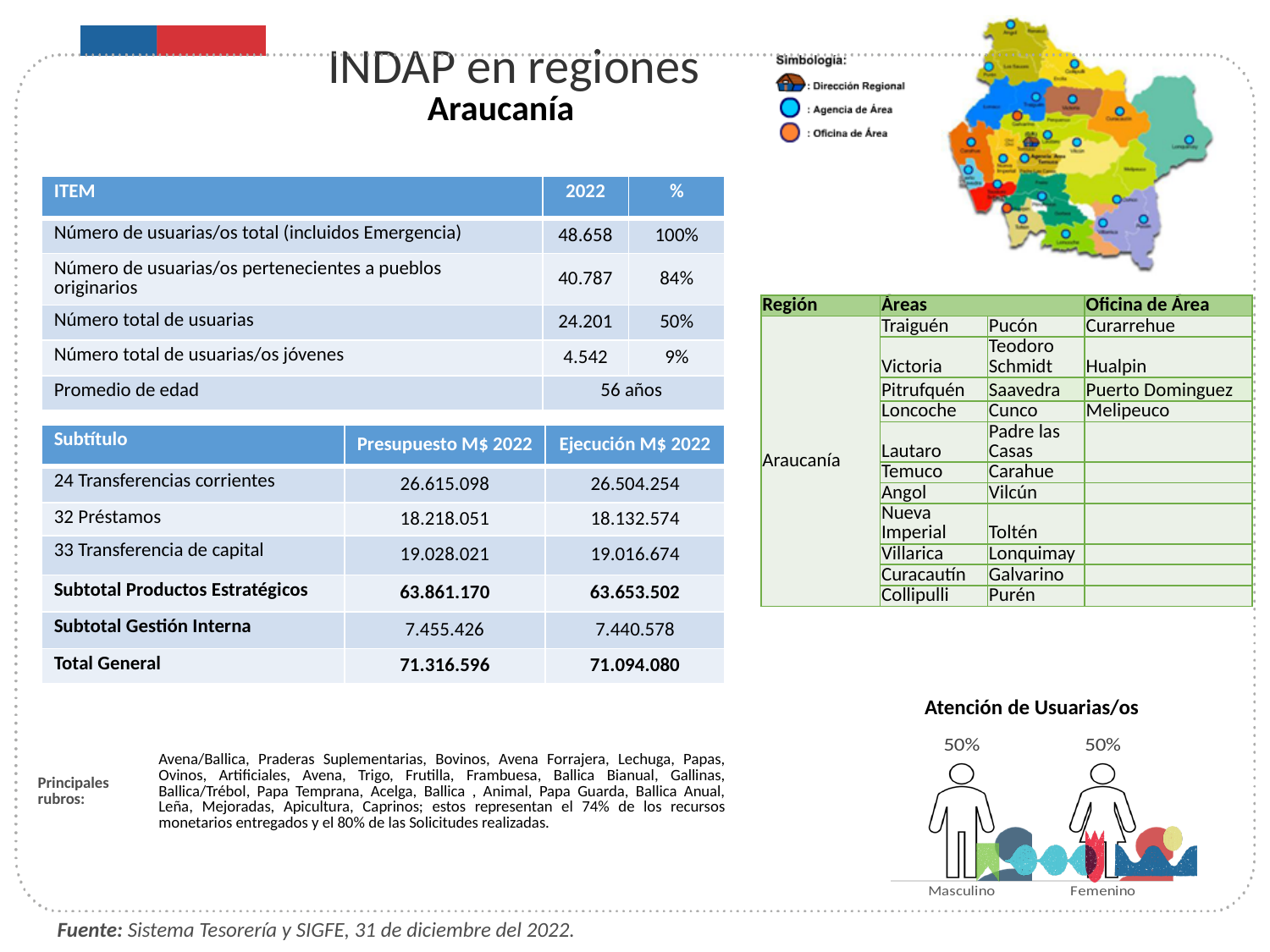
What are the two category labels shown along the bottom of the 'Atención de Usuarias/os' chart? Masculino and Femenino In the 'Atención de Usuarias/os' chart, are the values for Masculino and Femenino equal? Yes In the 'Atención de Usuarias/os' chart, what is the value for Femenino? 50% How many categories are shown in the 'Atención de Usuarias/os' chart? 2 In the 'Atención de Usuarias/os' chart, what is the difference between the Masculino and Femenino values? 0% What is the title of the chart on the slide? Atención de Usuarias/os In the 'Atención de Usuarias/os' chart, what is the value for Masculino? 50%